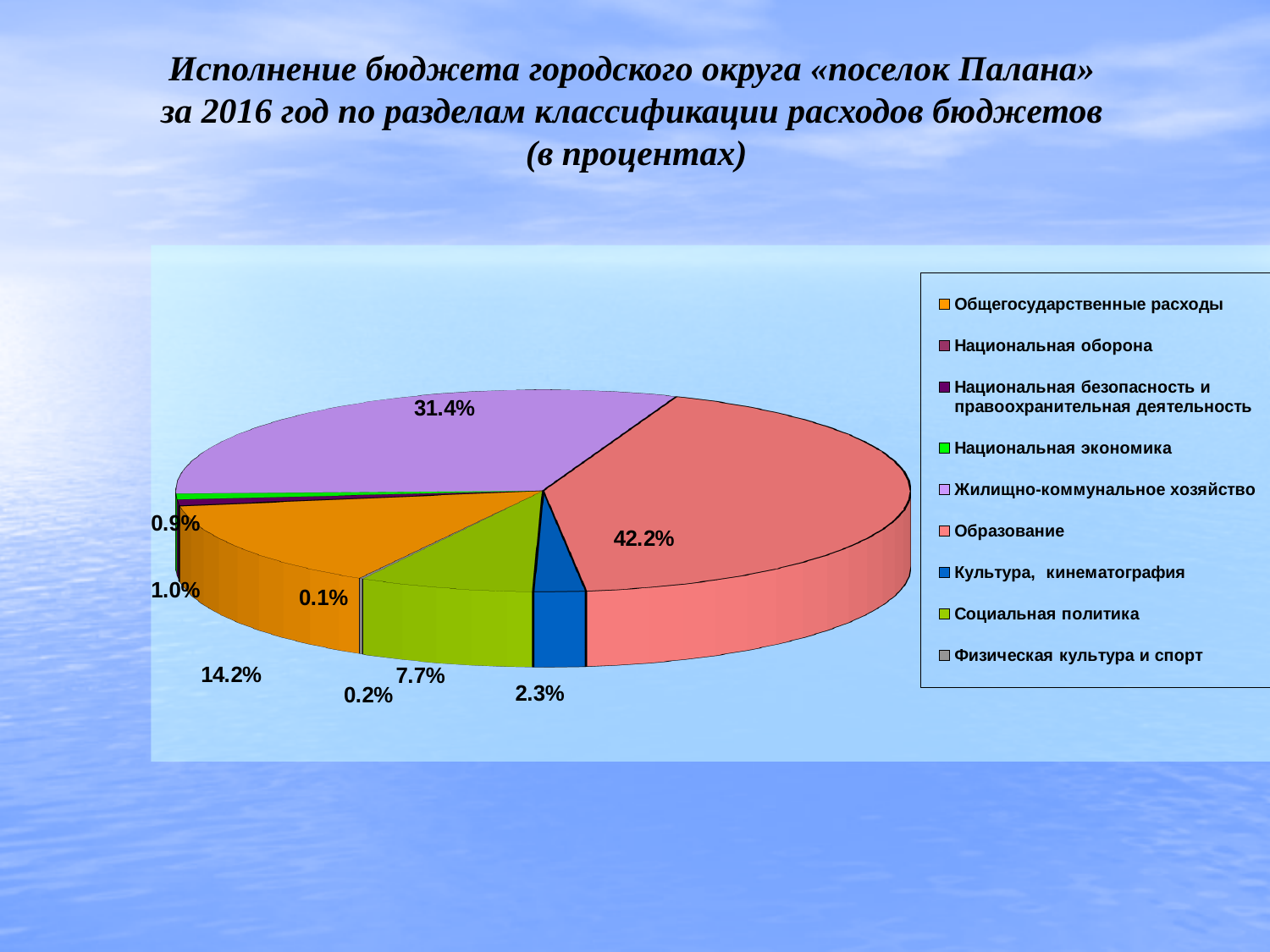
What share is shown for Жилищно-коммунальное хозяйство? 31.4% What percentage of the budget went to Образование? 42.2% What percentage is shown for Культура, кинематография? 2.3% For which year does the chart show the budget execution of городской округ «поселок Палана»? 2016 Which budget section has the largest share of the pie? Образование How many budget sections are listed in the legend? 9 By how many percentage points does Образование exceed Жилищно-коммунальное хозяйство? 10.8 Which is larger: Общегосударственные расходы or Социальная политика? Общегосударственные расходы What percentage is labelled for Общегосударственные расходы? 14.2% What is the value for Социальная политика? 7.7% What type of chart is shown on the slide? Pie chart What is the smallest percentage value labelled on the pie chart? 0.1%